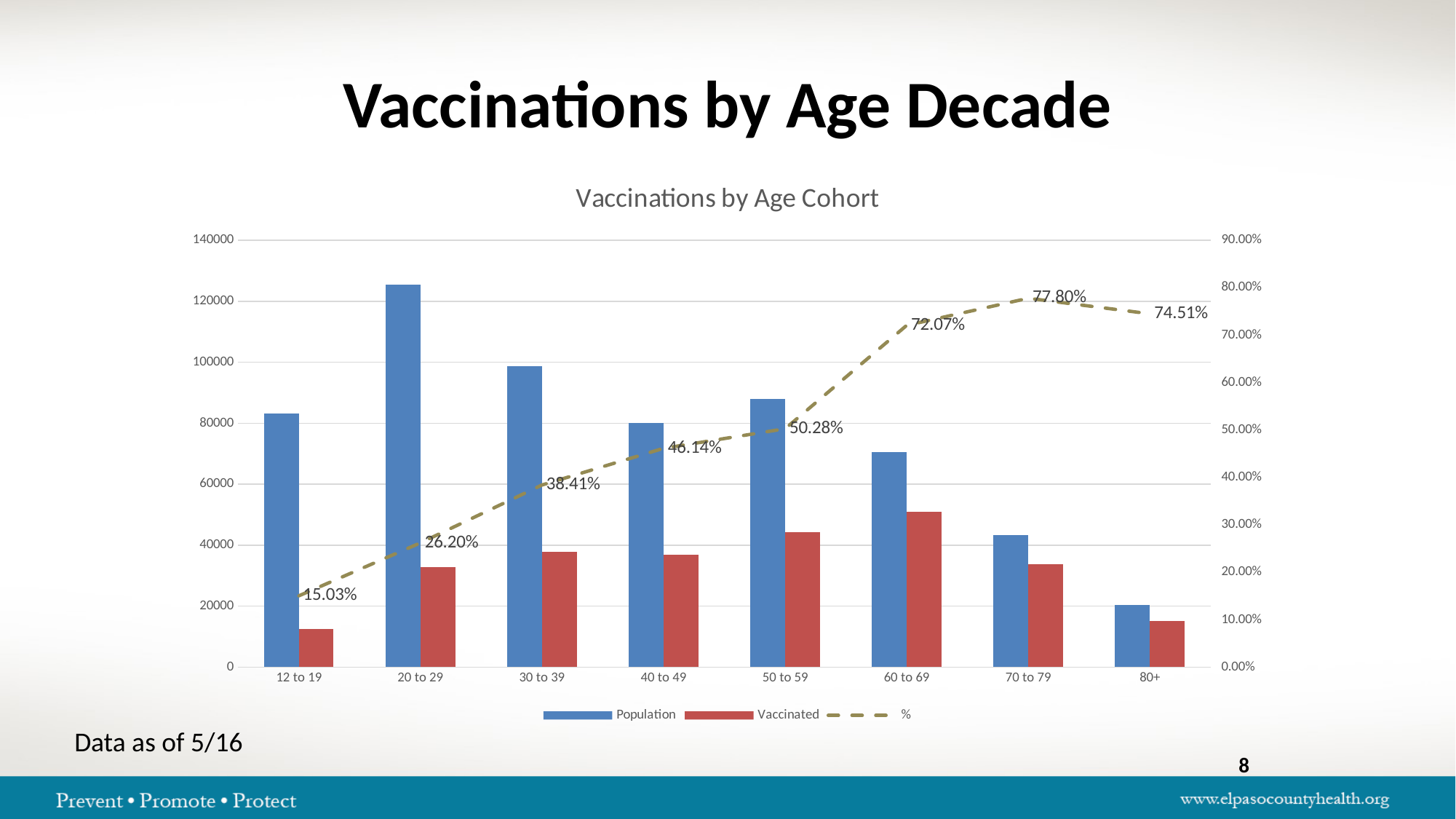
Is the Population value for the 20 to 29 age group greater or less than 120000? greater Which age group has the lowest vaccination percentage (%)? 12 to 19 How many series does the legend list? 3 Which has a higher vaccination percentage, the 60 to 69 group or the 80+ group? 80+ What is the difference in vaccination percentage between the 60 to 69 and 50 to 59 age groups? 21.79% What is the vaccination percentage (%) for the 40 to 49 age group? 46.14% Which age group has the highest vaccination percentage (%)? 70 to 79 Is the Vaccinated value for the 60 to 69 age group greater or less than 40000? greater How many age groups are shown on the x axis? 8 What is the difference in vaccination percentage between the 70 to 79 and 80+ age groups? 3.29% What is the vaccination percentage (%) for the 12 to 19 age group? 15.03% What is the vaccination percentage (%) for the 70 to 79 age group? 77.80%